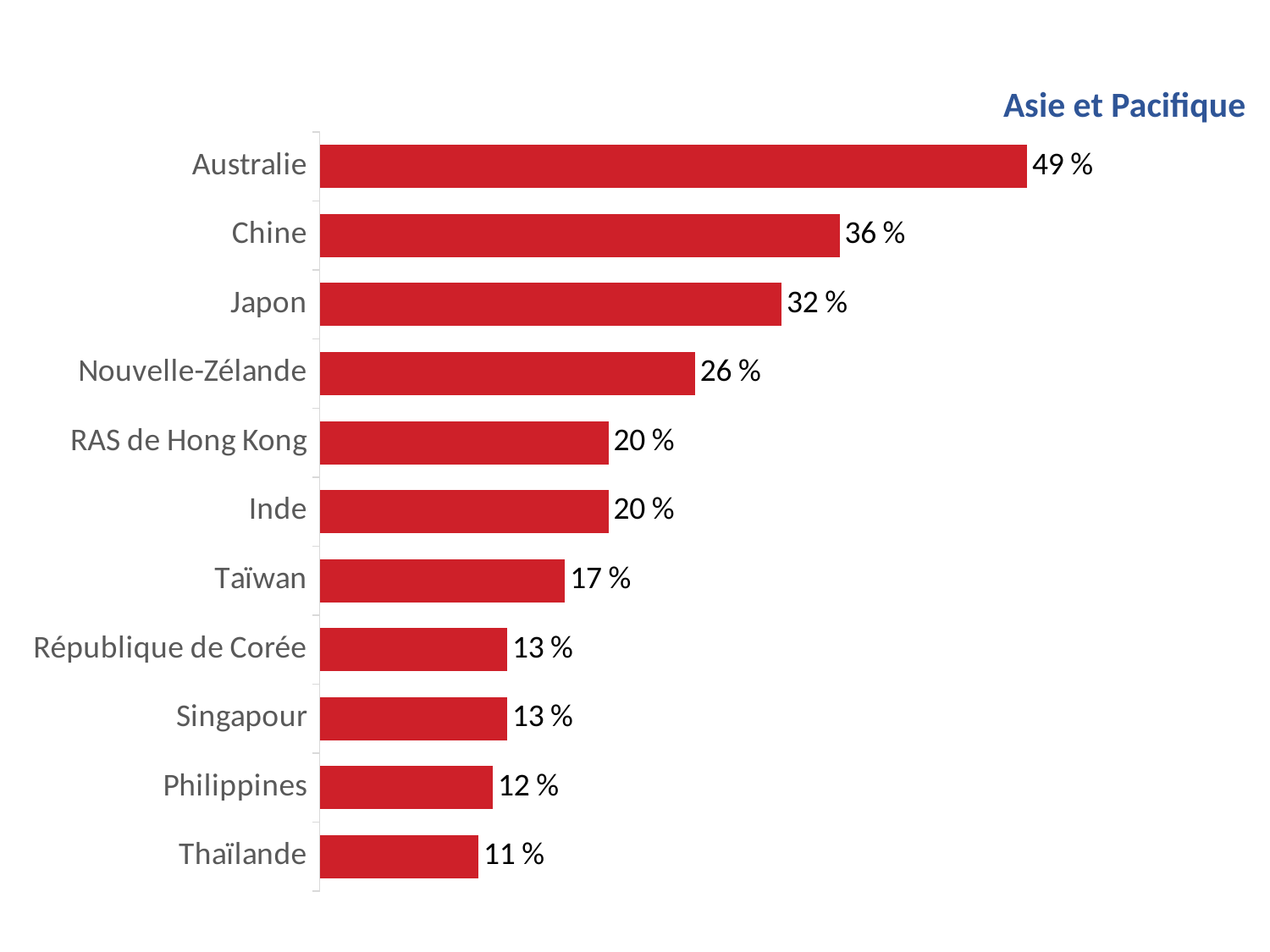
What is the value for Japon? 32 % What is the title of the chart? Asie et Pacifique What is the value for Australie? 49 % What is the value for Taïwan? 17 % Which is larger, the value for Chine or the value for Japon? Chine What is the value for Philippines? 12 % What is the difference between the values for Australie and Chine? 13 % What is the difference between the values for Nouvelle-Zélande and Inde? 6 % What kind of chart is this? Bar chart How many categories are shown in the chart? 11 Which category has the lowest value? Thaïlande Which category has the highest value? Australie